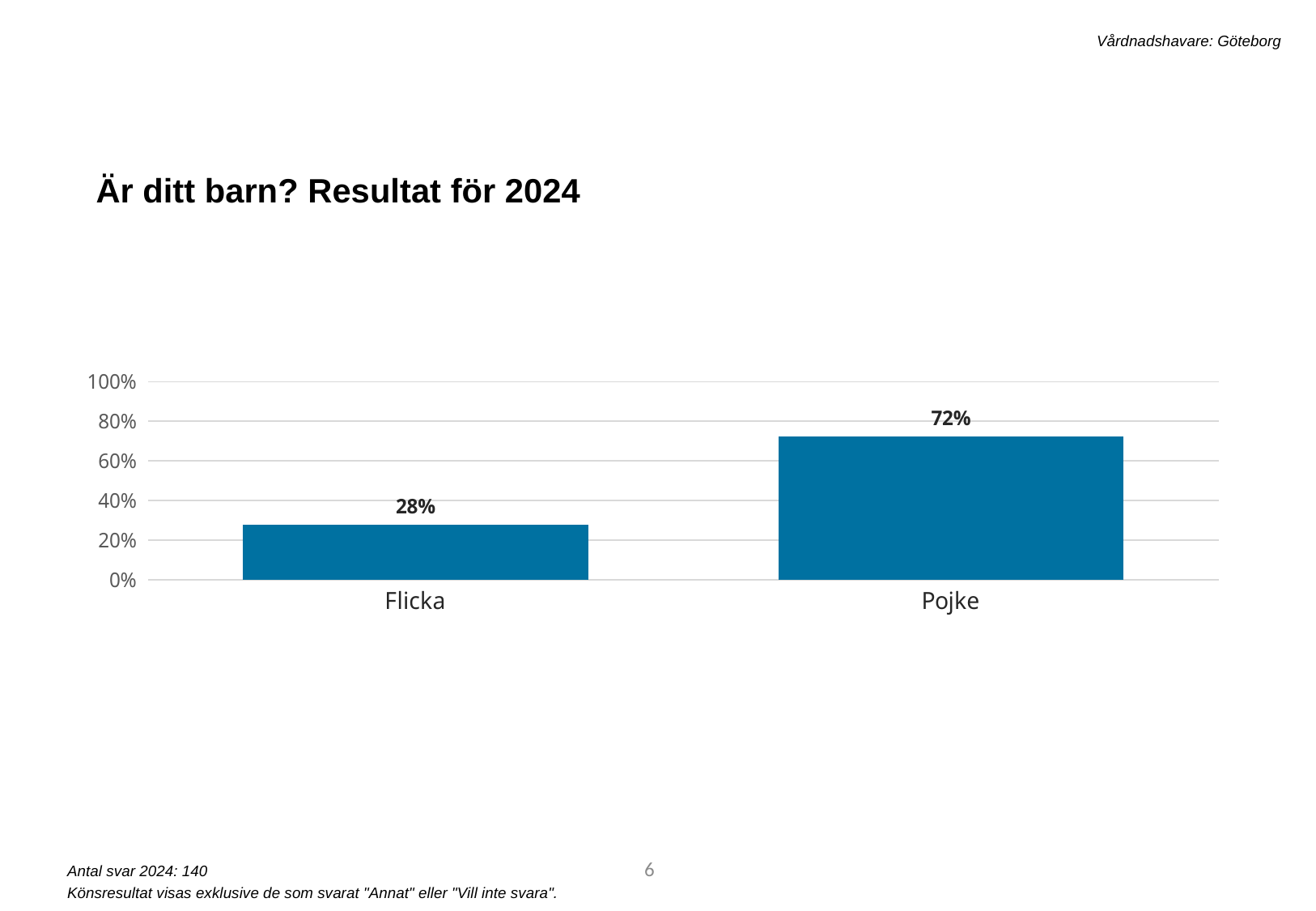
What is the value for Pojke? 72% What kind of chart is shown on the slide? bar chart Which category has the lowest value? Flicka What is the value for Flicka? 28% What is the highest value shown on the y axis? 100% What is the difference between the values for Pojke and Flicka? 44% Is the value for Flicka greater or less than 40%? less Which is larger, the value for Flicka or the value for Pojke? Pojke How many categories are shown on the x axis? 2 Is the value for Pojke greater or less than 60%? greater Which category has the highest value? Pojke What is the title of the chart? Är ditt barn? Resultat för 2024